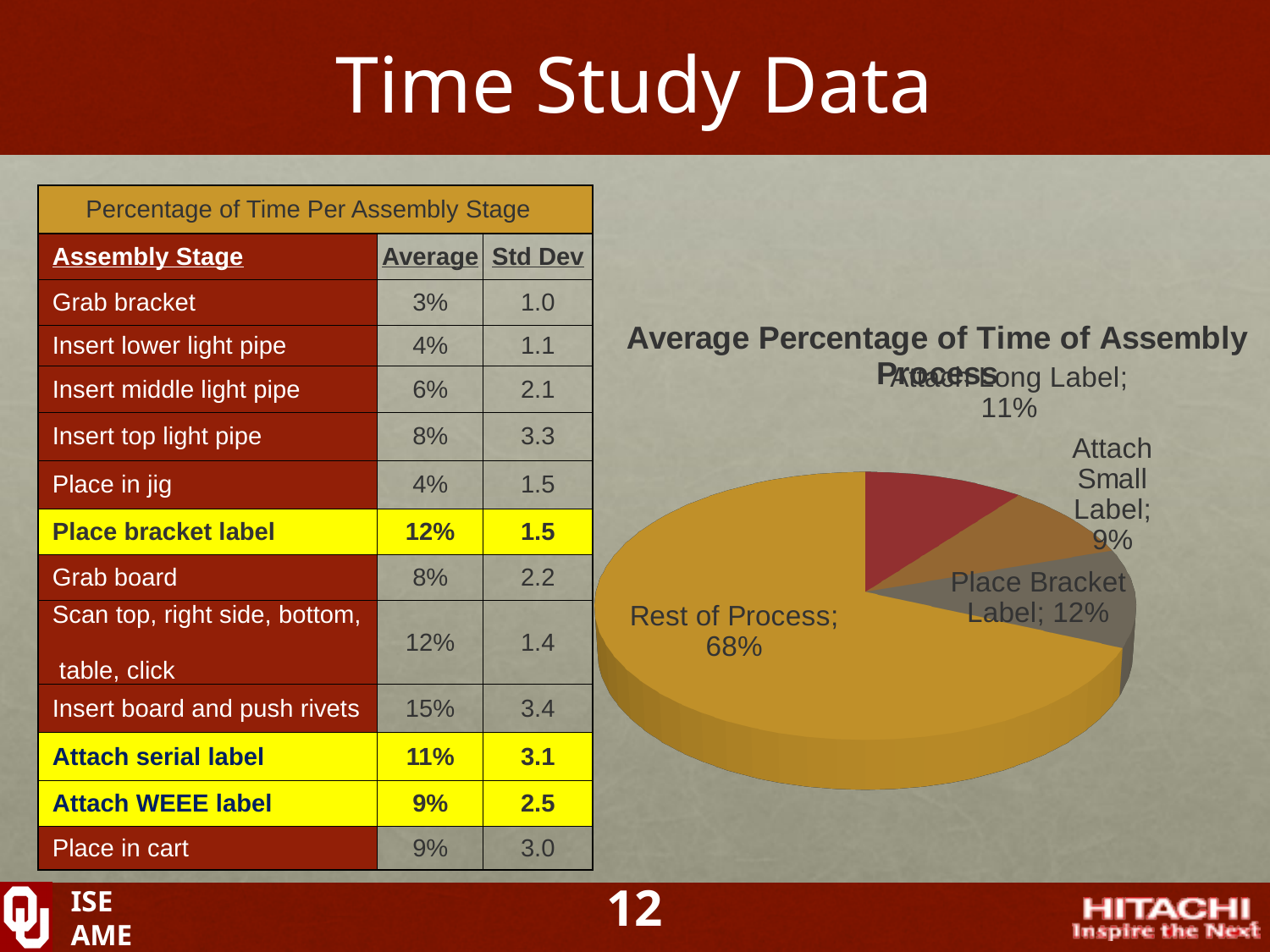
What percentage of the pie chart is labelled Place Bracket Label? 12% In the pie chart, which is larger: Place Bracket Label or Attach Long Label? Place Bracket Label In the pie chart, what is the difference between the Place Bracket Label slice and the Attach Small Label slice? 3% What is the title of the pie chart? Average Percentage of Time of Assembly Process Which slice of the pie chart is the largest? Rest of Process What percentage of the pie chart is labelled Rest of Process? 68% How many slices does the pie chart have? 4 In the pie chart, what is the combined share of the three label-attaching slices (Attach Long Label, Attach Small Label, Place Bracket Label)? 32% What percentage of the pie chart is labelled Attach Small Label? 9% Which slice of the pie chart is the smallest? Attach Small Label What kind of chart is shown on the slide? pie chart What percentage of the pie chart is labelled Attach Long Label? 11%